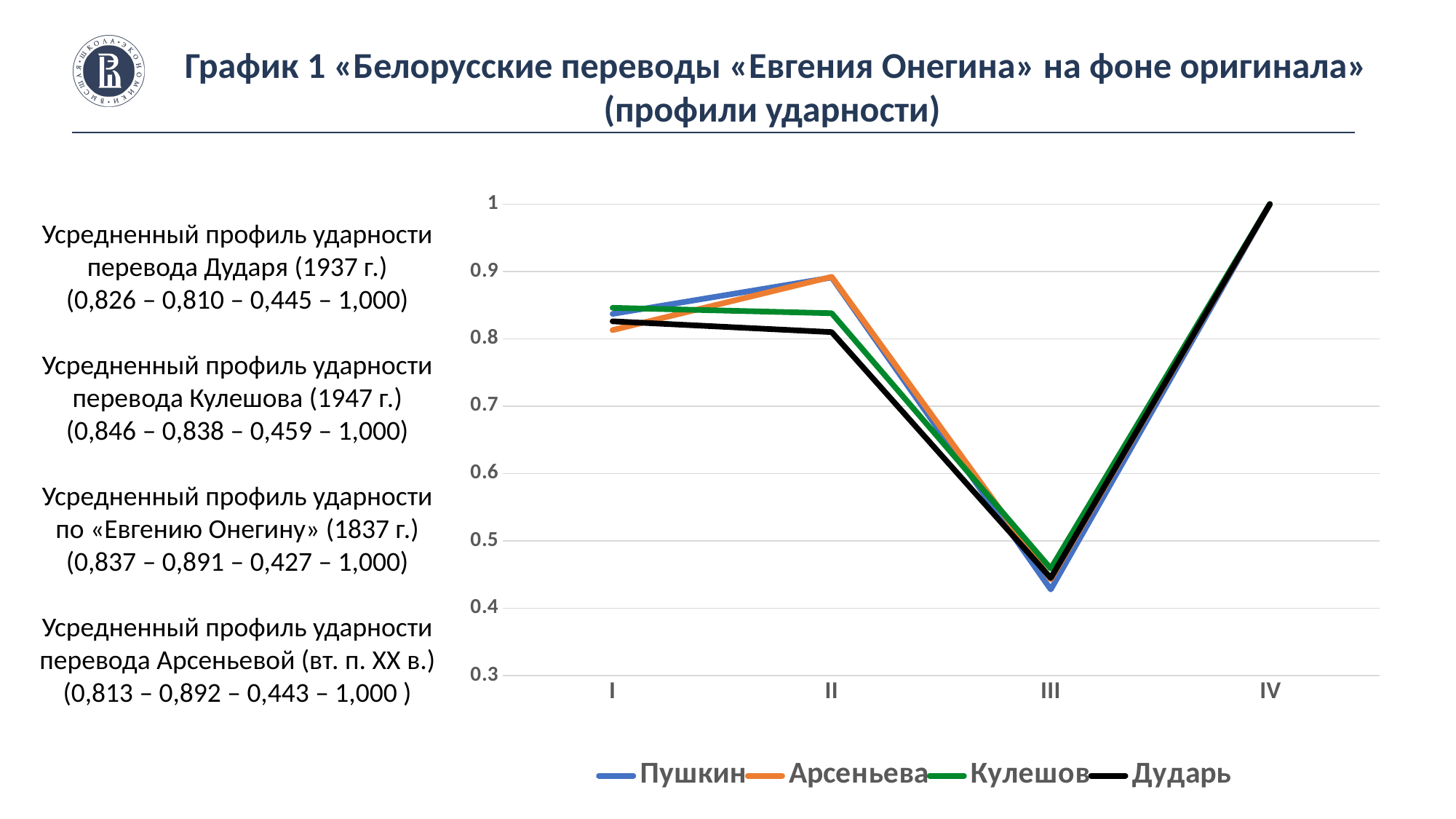
At which x-axis position do all series reach their highest value? IV How many points are there along the x axis? 4 Which series has the lowest value at position III? Пушкин What is the value for Арсеньева at position II? 0,892 Which is larger at position II: Пушкин or Дударь? Пушкин What is the difference between Кулешов and Пушкин at position III? 0,032 What is the value for Пушкин at position III? 0,427 At which x-axis position does the Кулешов series reach its lowest value? III Do the values fall or rise from position II to position III? fall What is the value for Дударь at position I? 0,826 How many series does the legend list? 4 What kind of chart is shown on the slide? line chart